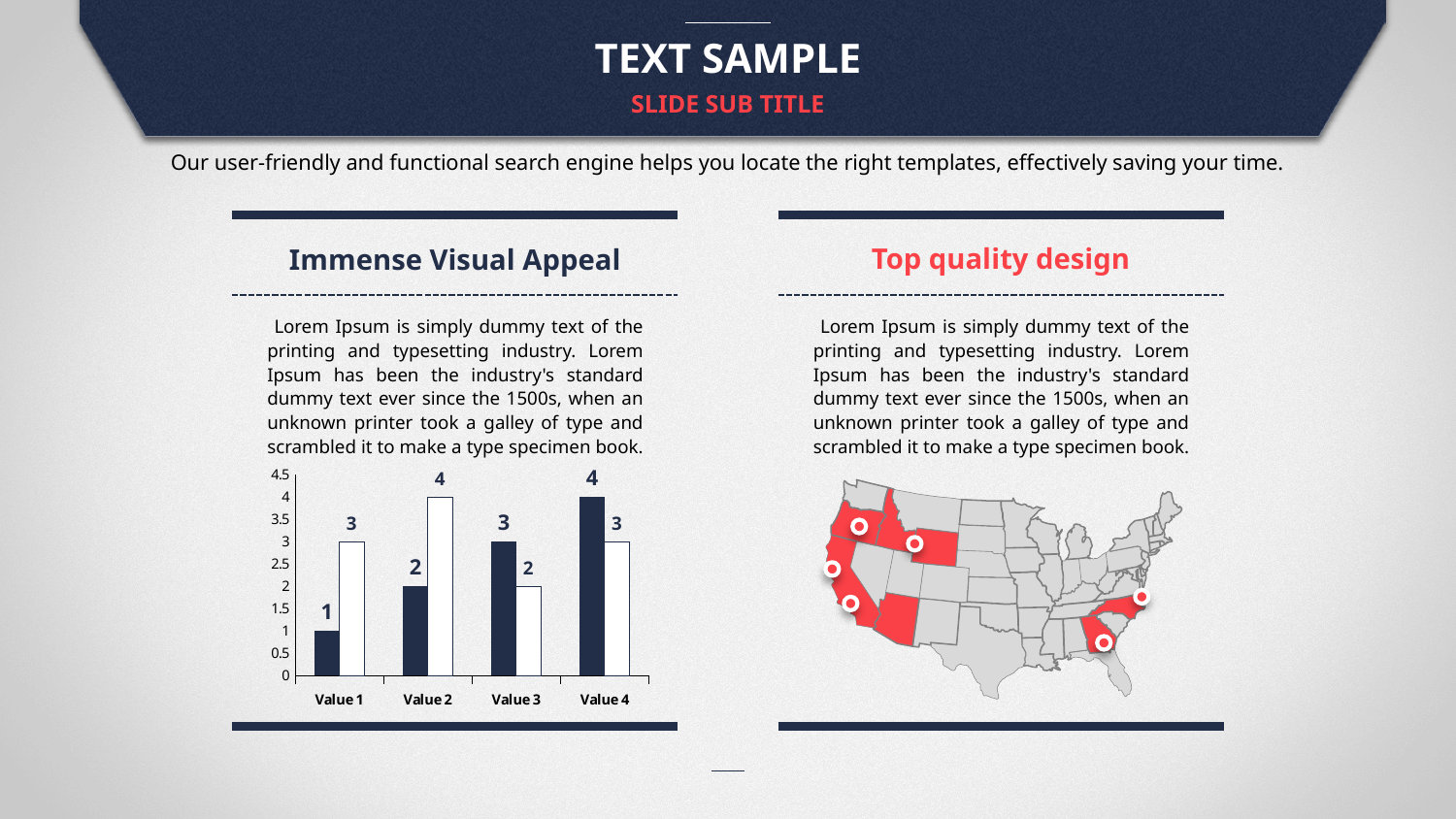
Do the dark bars rise or fall from Value 1 to Value 4? rise For Value 3, which is larger, the dark bar or the white bar? the dark bar How many categories are shown on the x axis of the bar chart? 4 What is the difference between the white bar and the dark bar for Value 1? 2 Which category has the highest dark bar? Value 4 Which category has the lowest dark bar? Value 1 What is the value of the white bar for Value 3? 2 What is the highest tick value shown on the y axis of the bar chart? 4.5 What type of chart is shown on the slide? bar chart What is the value of the white bar for Value 2? 4 What is the value of the dark bar for Value 4? 4 What is the value of the dark bar for Value 1? 1